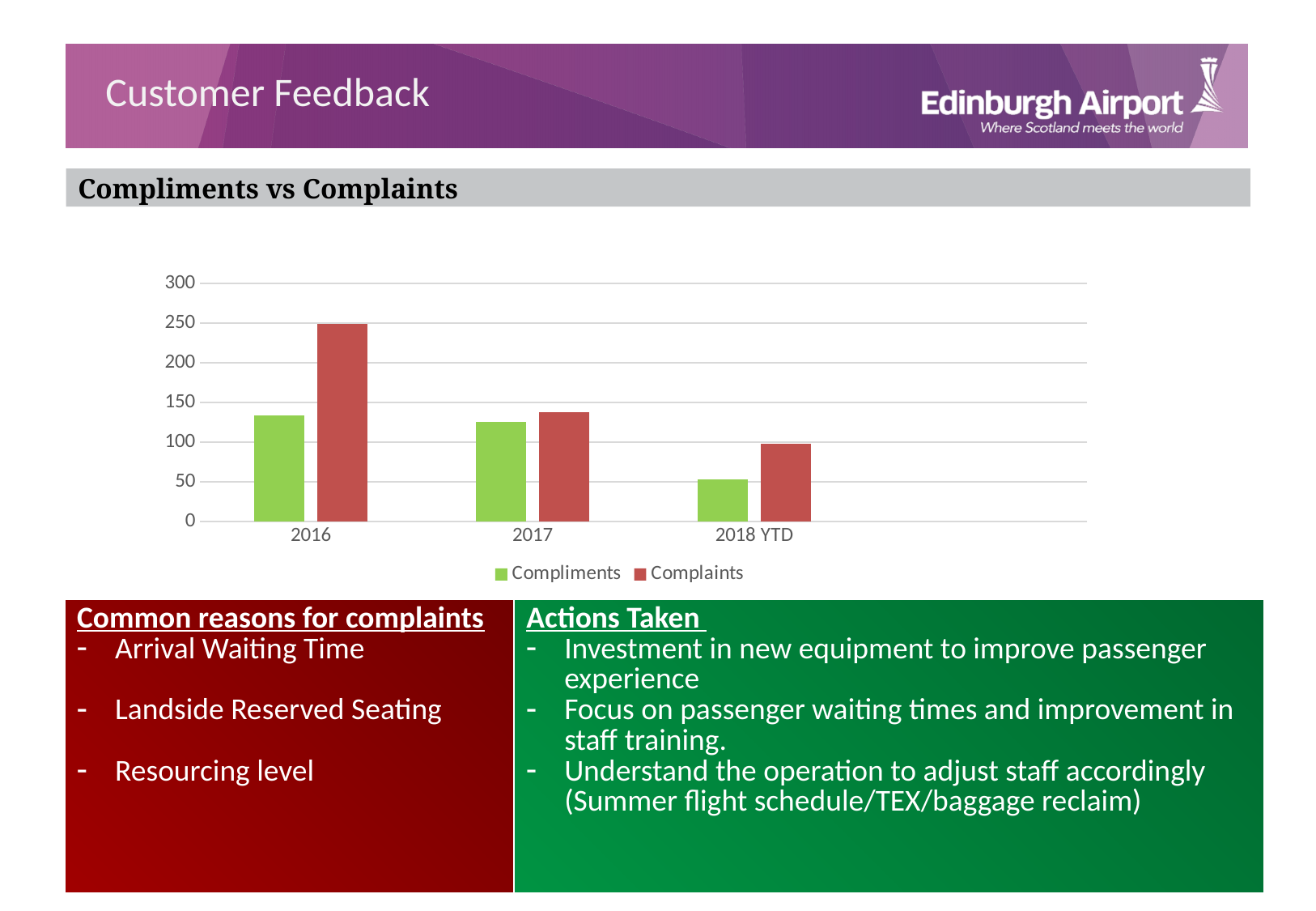
Which year has the highest Complaints value? 2016 What kind of chart is shown on the slide? bar chart Do the Compliments values rise or fall from 2016 to 2018 YTD? fall Is the Compliments value for 2017 greater or less than 100? greater In 2016, which is larger, Compliments or Complaints? Complaints Which category has the lowest Compliments value? 2018 YTD How many series does the chart legend list? 2 Which colour represents Complaints in the chart? red How many categories are shown on the x axis of the chart? 3 What is the title of the chart? Compliments vs Complaints Is the Complaints value for 2016 greater or less than 200? greater Is the Compliments value for 2018 YTD greater or less than 100? less